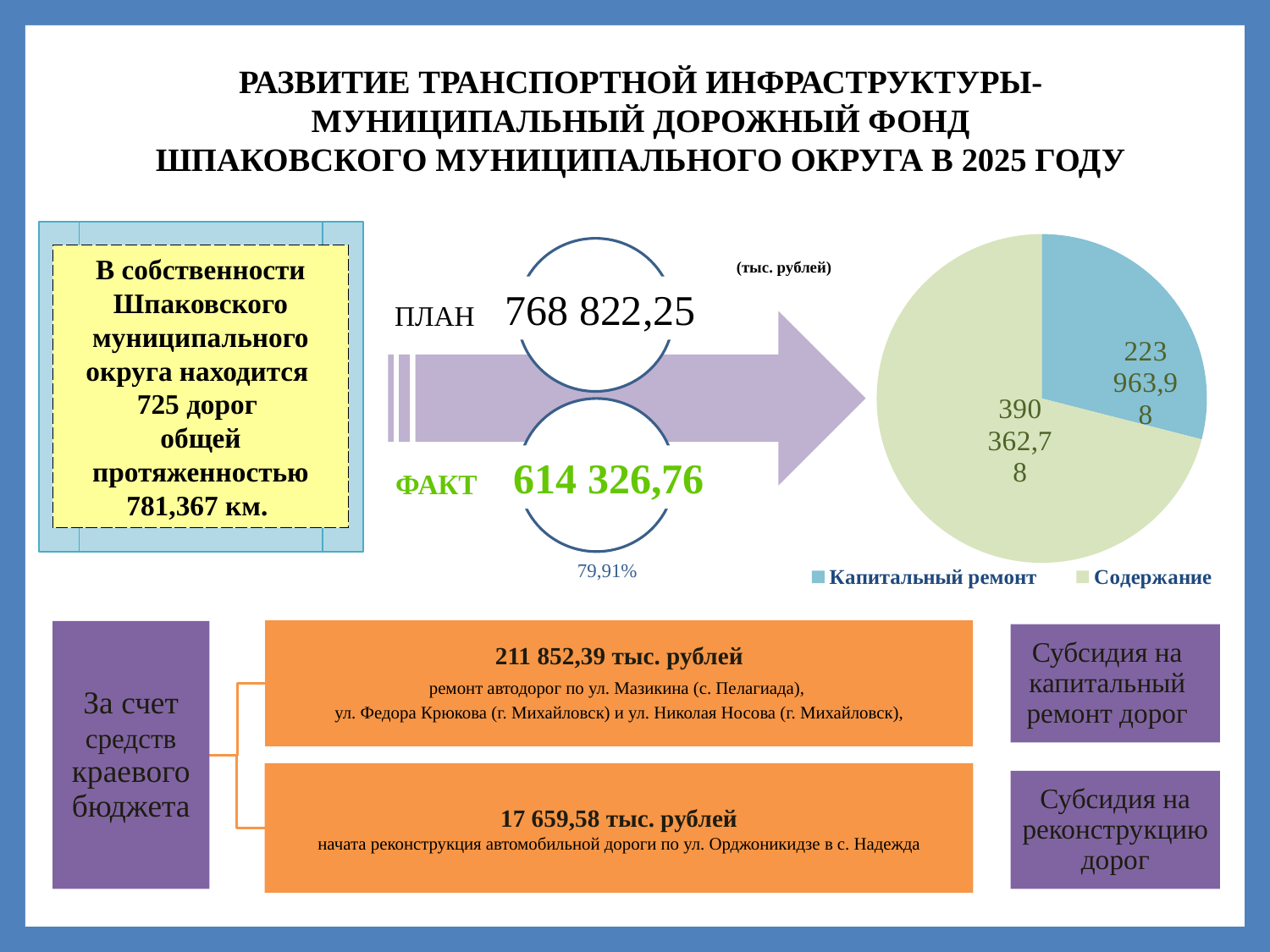
What kind of chart is shown on the right side of the slide? pie chart What is the difference between the Содержание and Капитальный ремонт values in the pie chart? 166 398,80 How many entries does the legend of the pie chart list? 2 Which slice of the pie chart is the smallest? Капитальный ремонт How many slices does the pie chart have? 2 What is the total of the two slices in the pie chart? 614 326,76 Which slice of the pie chart is the largest? Содержание What is the value for Содержание in the pie chart? 390 362,78 What colour is the Содержание slice in the pie chart? light green What is the value for Капитальный ремонт in the pie chart? 223 963,98 In the pie chart, which is larger: Капитальный ремонт or Содержание? Содержание What colour is the Капитальный ремонт slice in the pie chart? blue